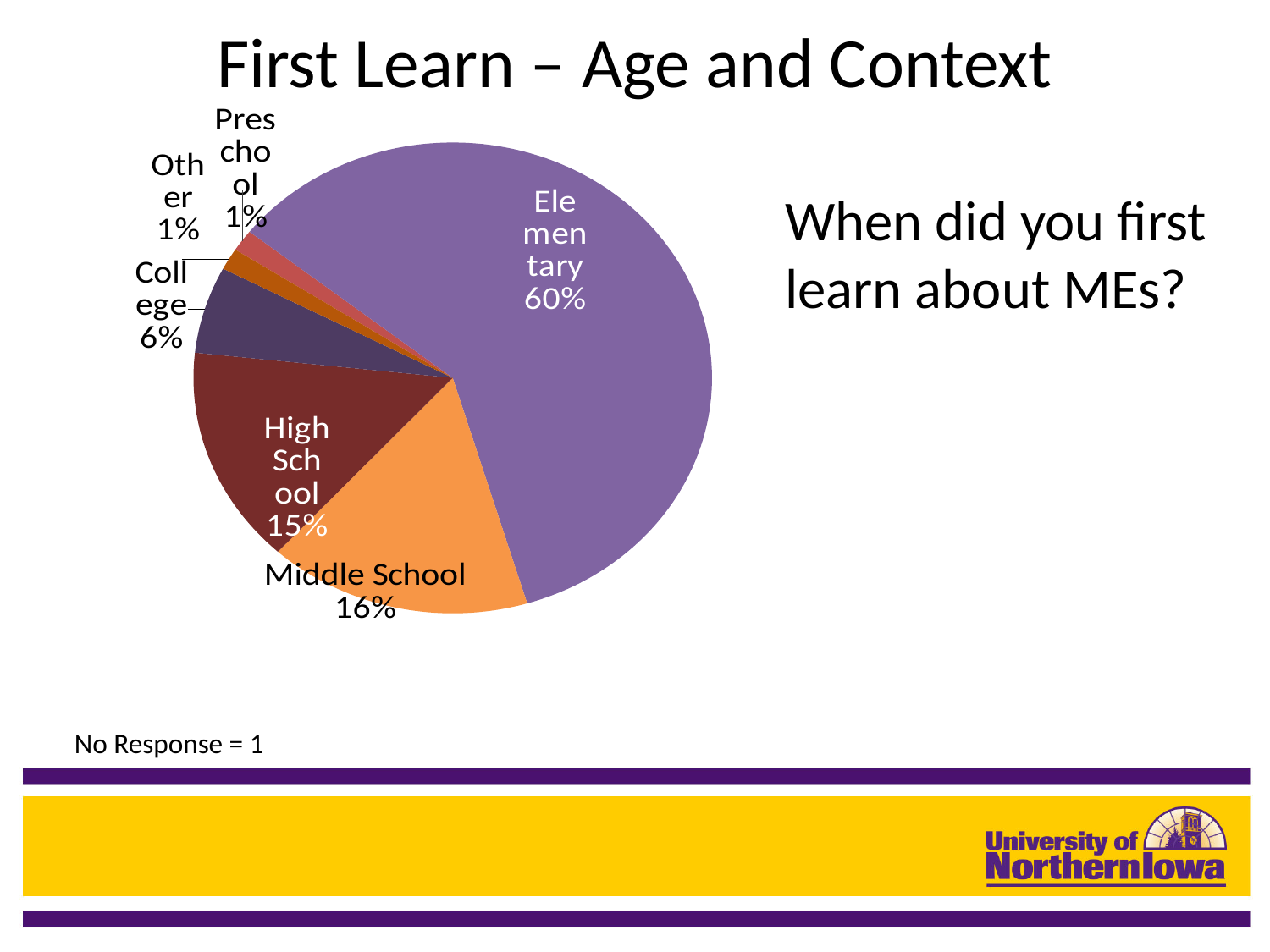
What share of the pie is College? 6% Which category has the largest slice of the pie? Elementary What is the title of the slide containing the pie chart? First Learn – Age and Context What share of the pie is Elementary? 60% What is the difference in percentage points between Elementary and Middle School? 44 What share of the pie is High School? 15% How many slices does the pie chart have? 6 What is the difference in percentage points between College and Other? 5 What kind of chart is shown on the slide? pie chart Which is larger, the Middle School slice or the High School slice? Middle School